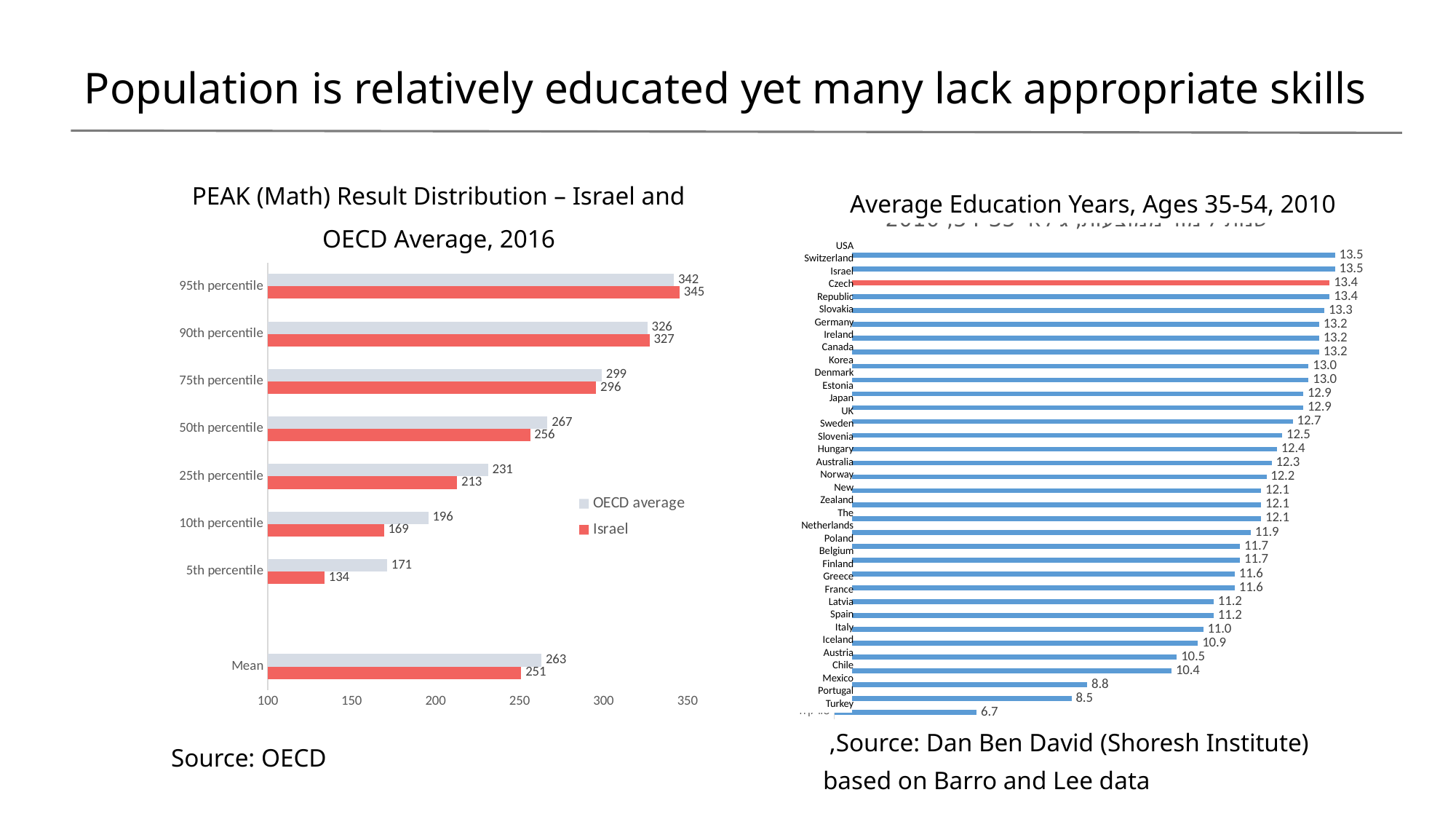
In the PEAK (Math) Result Distribution chart, what is the difference between the OECD average and Israel at the 10th percentile? 27 In the PEAK (Math) Result Distribution chart, what is Israel's Mean value? 251 In the Average Education Years chart on the right, what is the lowest value shown? 6.7 In the PEAK (Math) Result Distribution chart, which is larger at the 50th percentile, the OECD average or Israel? OECD average How many categories are shown on the y axis of the PEAK (Math) Result Distribution chart? 8 In the Average Education Years chart on the right, what value is labelled on the red bar? 13.4 What kind of chart is the PEAK (Math) Result Distribution chart? bar chart In the Average Education Years chart on the right, what is the highest value shown? 13.5 In the PEAK (Math) Result Distribution chart, what is the difference between the OECD average and Israel at the 25th percentile? 18 In the PEAK (Math) Result Distribution chart, what is Israel's value at the 95th percentile? 345 In the PEAK (Math) Result Distribution chart, what is the OECD average at the 5th percentile? 171 How many series does the legend of the PEAK (Math) Result Distribution chart list? 2